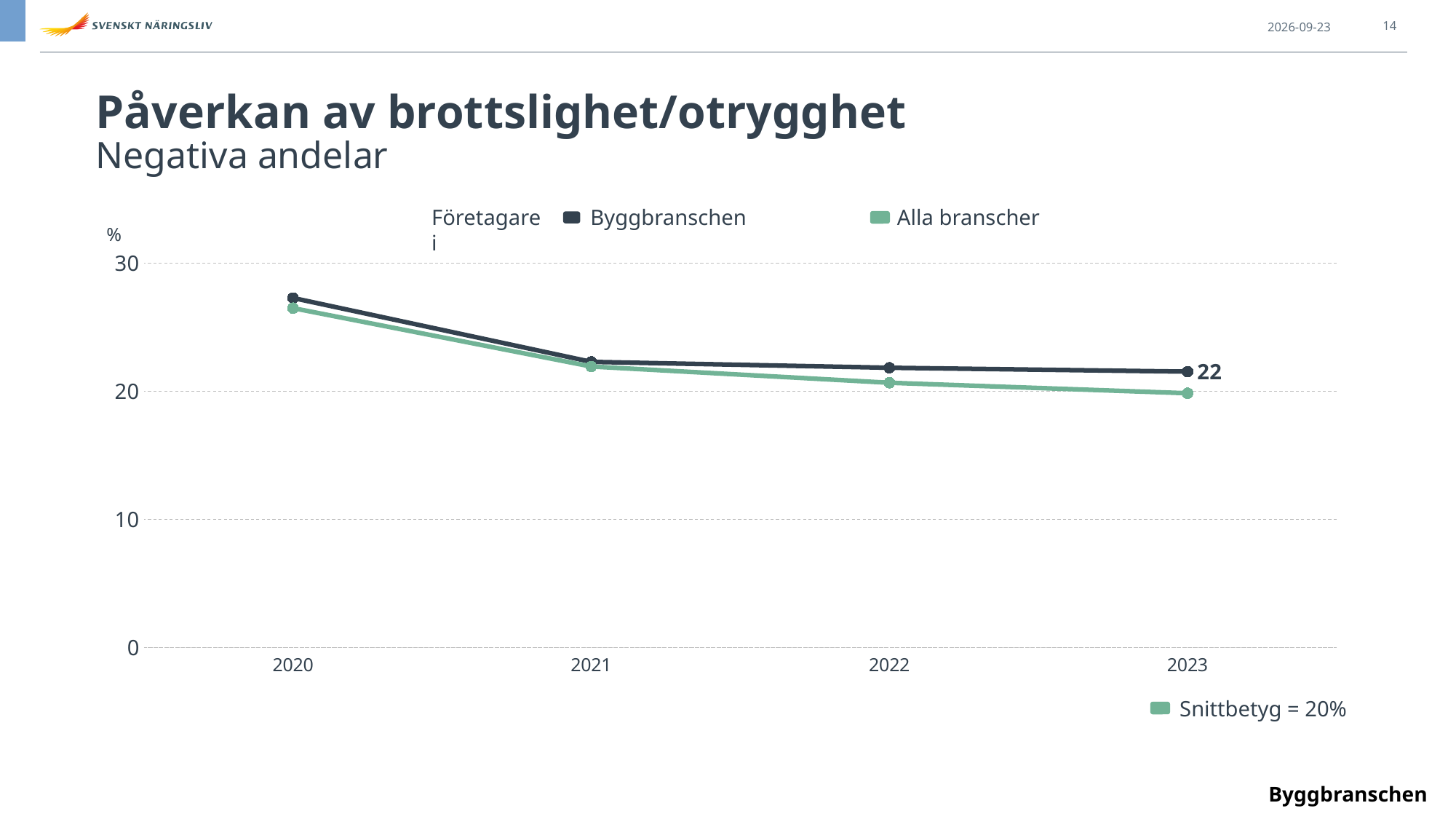
In which year is the value for Byggbranschen highest? 2020 Is the value for Alla branscher in 2021 greater or less than 30? less How many years are plotted on the x axis? 4 Is the value for Alla branscher in 2022 greater or less than 10? greater Is the value for Byggbranschen in 2020 greater or less than 20? greater What kind of chart is shown on the slide? line chart Do the values for Byggbranschen rise or fall from 2020 to 2023? fall What is the title of the chart on the slide? Påverkan av brottslighet/otrygghet How many series does the legend list? 2 In which year is the value for Alla branscher lowest? 2023 In 2023, which series has the larger value, Byggbranschen or Alla branscher? Byggbranschen What is the value for Byggbranschen in 2023? 22